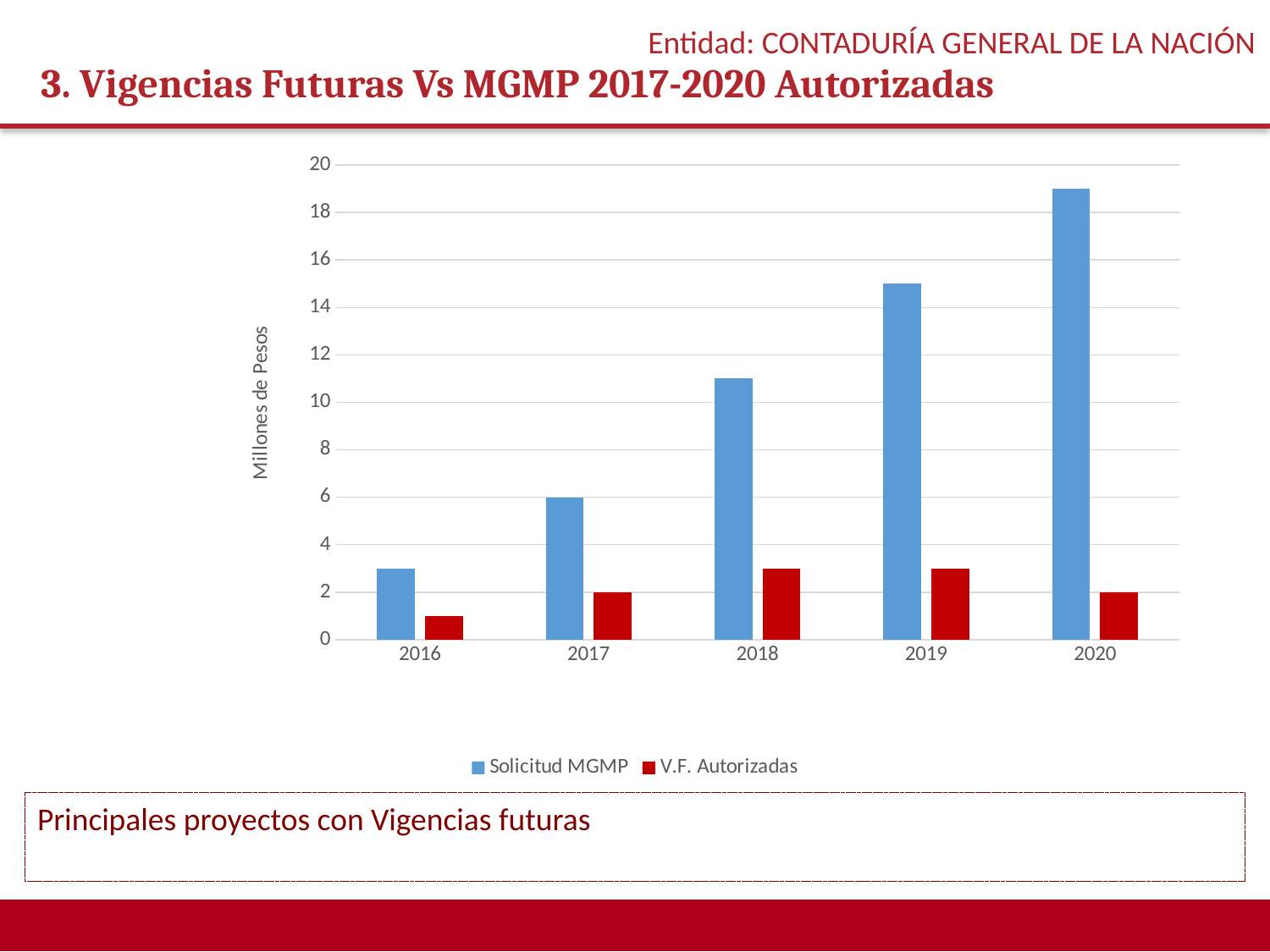
In which year is V.F. Autorizadas lowest? 2016 What is the value of V.F. Autorizadas for 2020? 2 Is the value for Solicitud MGMP in 2020 greater or less than 18? greater What is the difference between Solicitud MGMP and V.F. Autorizadas in 2017? 4 What kind of chart is shown on the slide? bar chart Does Solicitud MGMP rise or fall from 2016 to 2020? rise What is the value of Solicitud MGMP for 2017? 6 In which year is Solicitud MGMP highest? 2020 Is the value for Solicitud MGMP in 2018 greater or less than 10? greater How many series does the legend list? 2 What is the value of V.F. Autorizadas for 2017? 2 How many years are shown on the x axis? 5